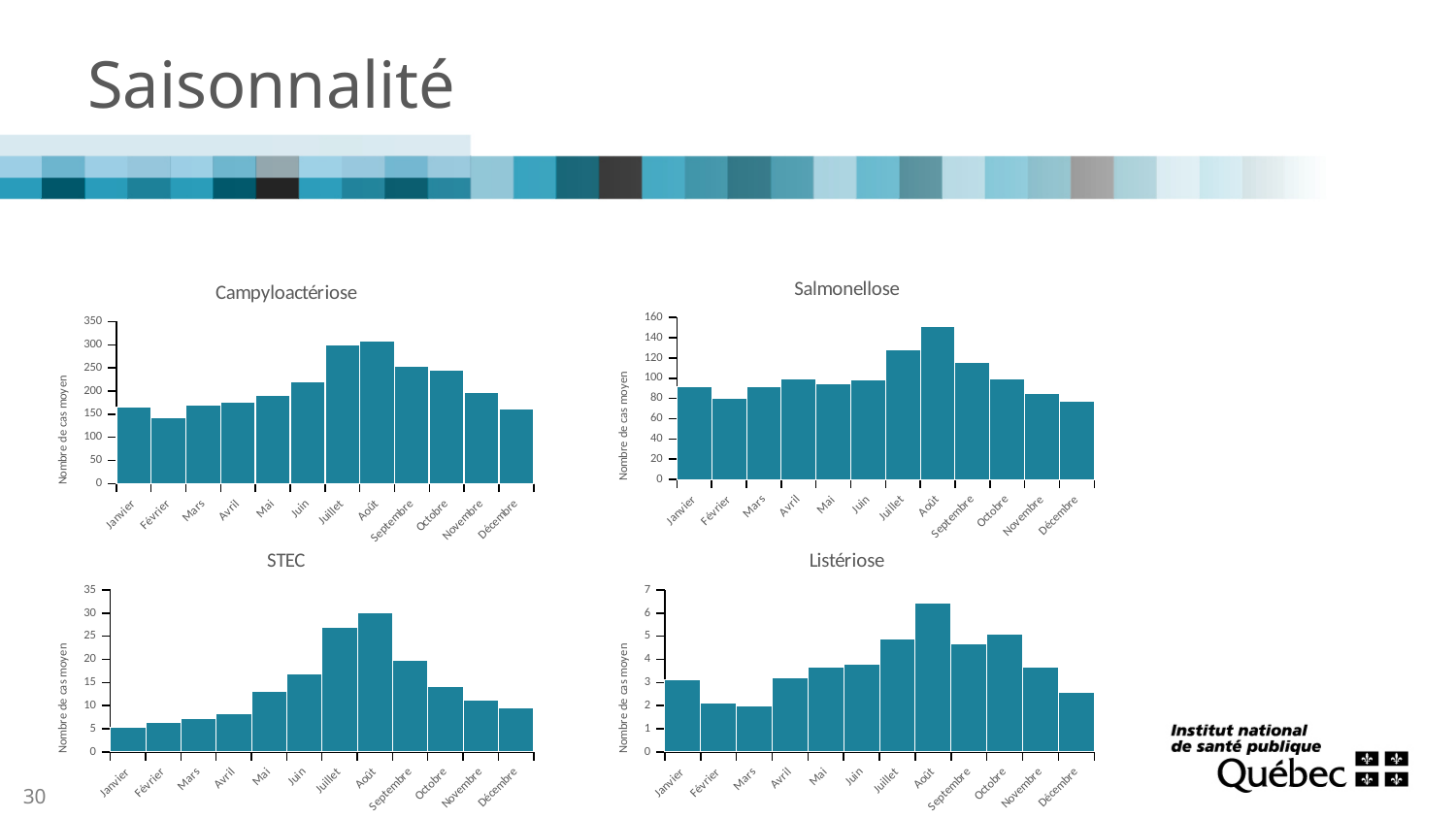
What kind of chart is the Campyloactériose chart? bar chart In the Salmonellose chart, which is larger, the value for Juillet or the value for Septembre? Juillet In the Campyloactériose chart, which month has the lowest value? Février In the Salmonellose chart, which month has the highest value? Août In the Campyloactériose chart, which month has the highest value? Août In the Campyloactériose chart, is the value for Juillet greater or less than 250? greater In the Salmonellose chart, is the value for Août greater or less than 140? greater In the Listériose chart, is the value for Février greater or less than 3? less In the Campyloactériose chart, how many months are plotted on the x axis? 12 In the STEC chart, do the values rise or fall from Janvier to Août? rise How many charts are shown on the slide? 4 In the STEC chart, which month has the highest value? Août